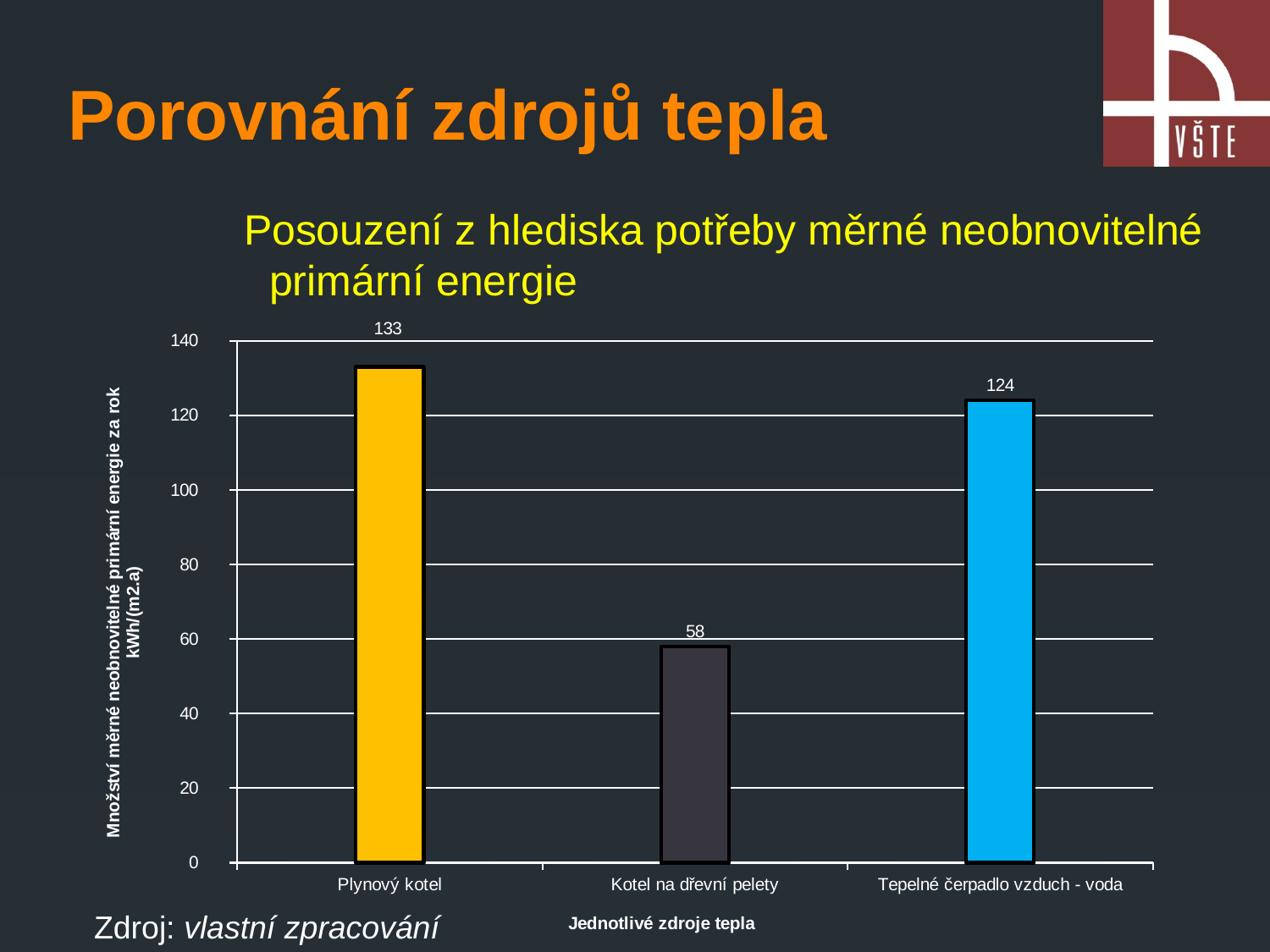
Which heat source has the highest value? Plynový kotel What is the difference between the values for Plynový kotel and Tepelné čerpadlo vzduch - voda? 9 What is the value for Plynový kotel? 133 Is the value for Kotel na dřevní pelety greater or less than 60? less How many heat sources are shown on the chart? 3 What is the difference between the values for Tepelné čerpadlo vzduch - voda and Kotel na dřevní pelety? 66 Which heat source has the lowest value? Kotel na dřevní pelety What is the value for Tepelné čerpadlo vzduch - voda? 124 Which is larger, the value for Kotel na dřevní pelety or the value for Tepelné čerpadlo vzduch - voda? Tepelné čerpadlo vzduch - voda What is the x-axis title of the chart? Jednotlivé zdroje tepla What kind of chart is shown on the slide? bar chart What is the value for Kotel na dřevní pelety? 58